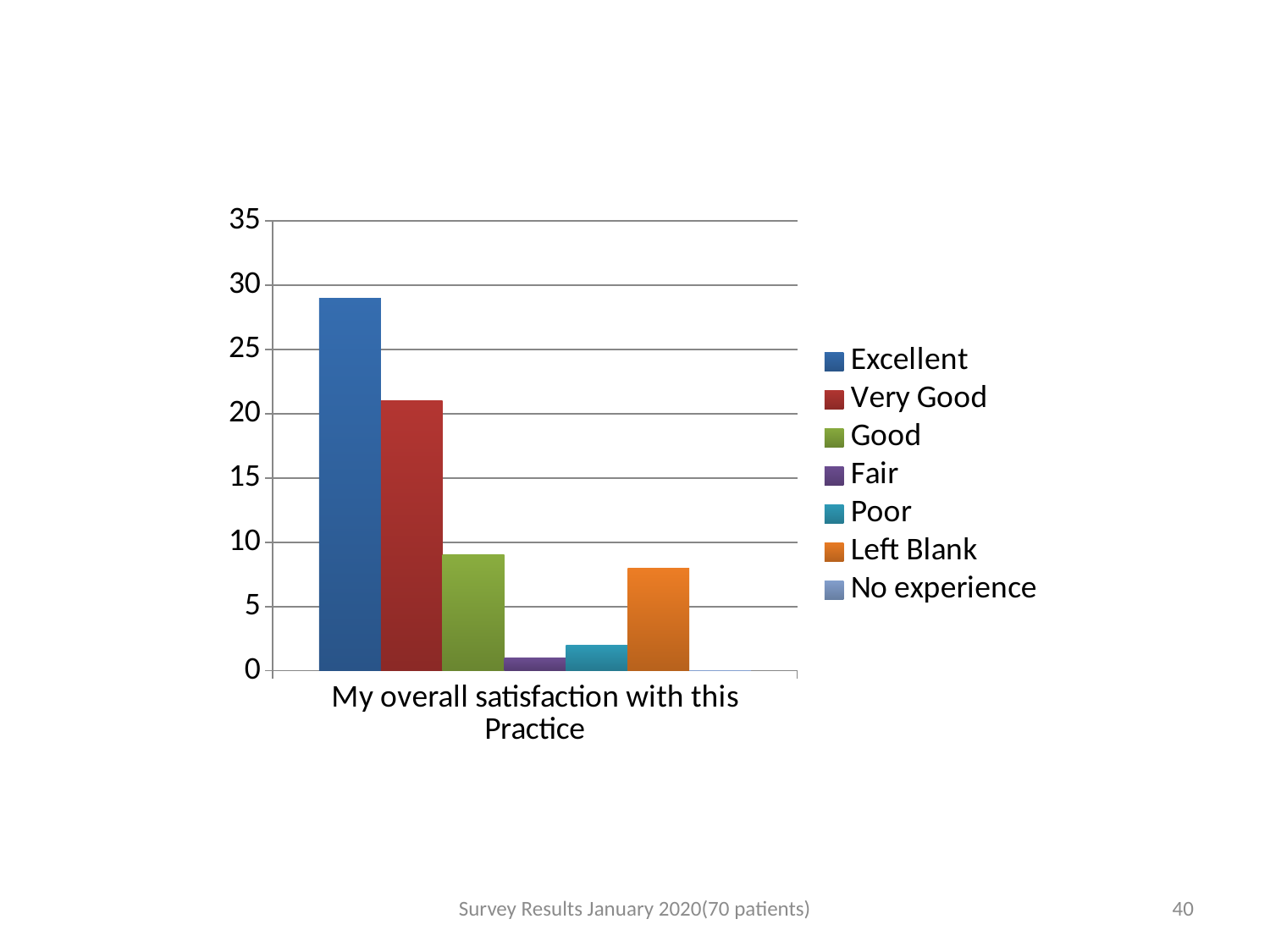
Is the value for Poor greater or less than 5? less Is the value for Very Good greater or less than 15? greater Is the value for Left Blank greater or less than 10? less What kind of chart is shown on the slide? bar chart Which series has the highest value? Excellent What is the category label shown on the x axis? My overall satisfaction with this Practice Which is larger, the value for Excellent or the value for Very Good? Excellent How many series does the legend list? 7 Which is larger, the value for Very Good or the value for Good? Very Good How many categories are shown on the x axis? 1